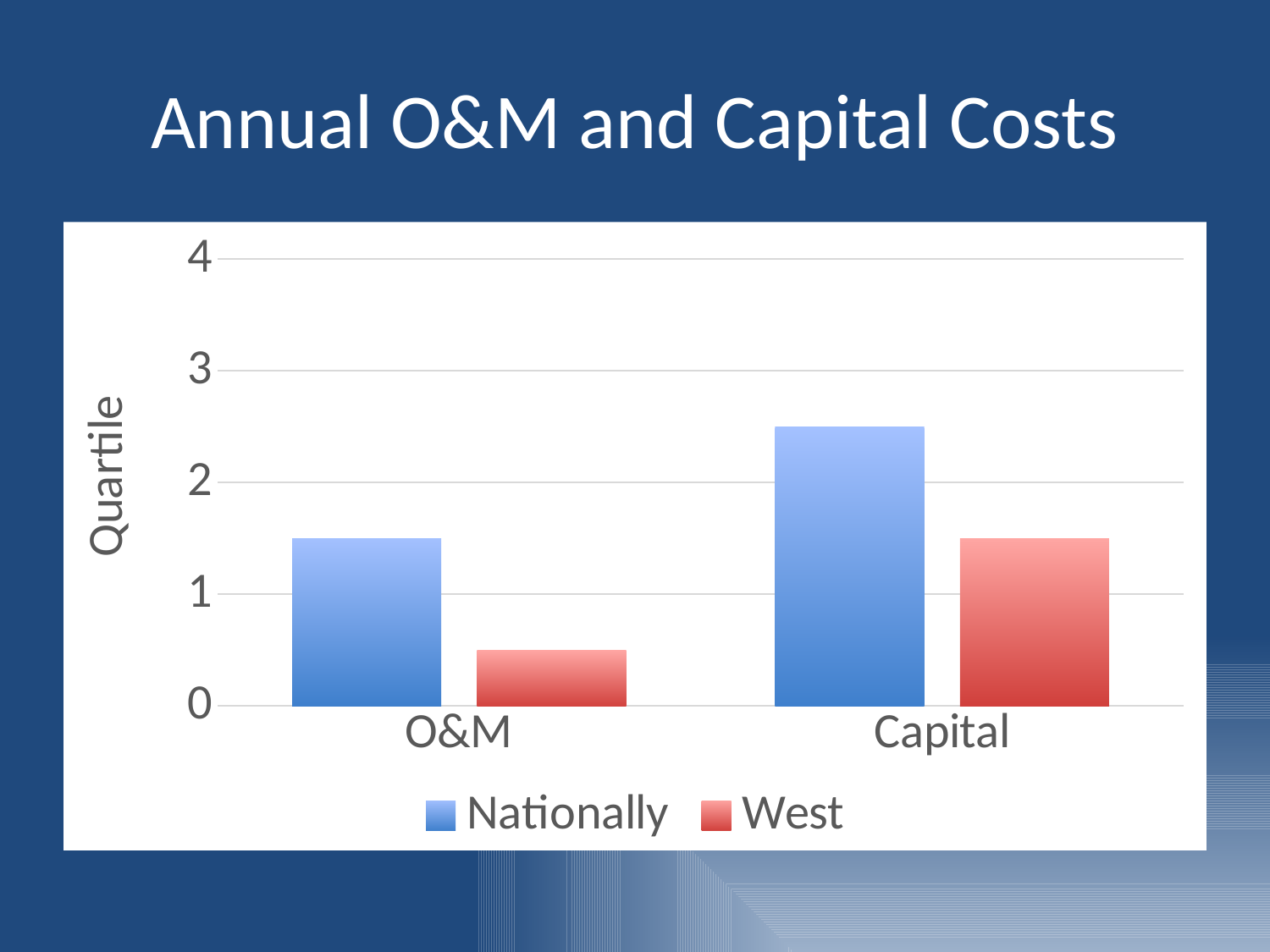
Is the West value for O&M greater or less than 1? less What kind of chart is shown on the slide? bar chart How many categories are shown on the x axis? 2 Is the West value for Capital greater or less than 2? less Which is larger for Capital, the Nationally value or the West value? Nationally What is the title of the chart? Annual O&M and Capital Costs Is the Nationally value for O&M greater or less than 1? greater How many series does the legend list? 2 Which category has the lowest West value? O&M Which category has the highest Nationally value? Capital What is the label of the vertical axis? Quartile